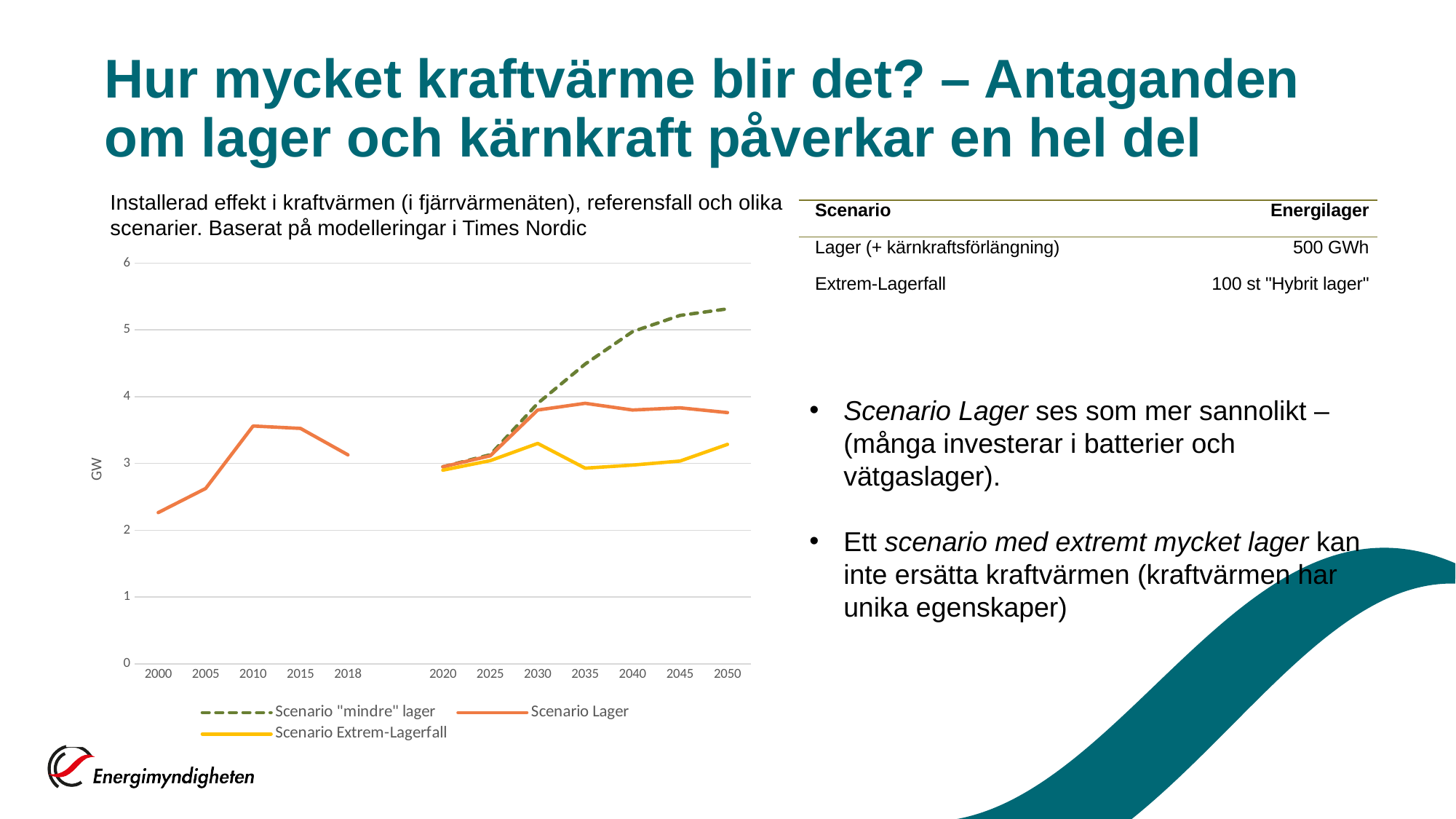
How many year labels are shown on the x axis of the chart? 12 Is the value for Scenario Lager in 2050 greater or less than 4? less What unit is shown on the y axis of the chart? GW Is the value for Scenario Lager in 2010 greater or less than 3? greater Which series has the highest value in 2050? Scenario "mindre" lager Is the value for Scenario Lager in 2000 greater or less than 3? less Which series is drawn as a dashed line in the chart? Scenario "mindre" lager Which series has the lowest value in 2050? Scenario Extrem-Lagerfall What kind of chart is shown on the slide? Line chart Does the Scenario "mindre" lager line rise or fall from 2020 to 2050? Rise How many series does the chart legend list? 3